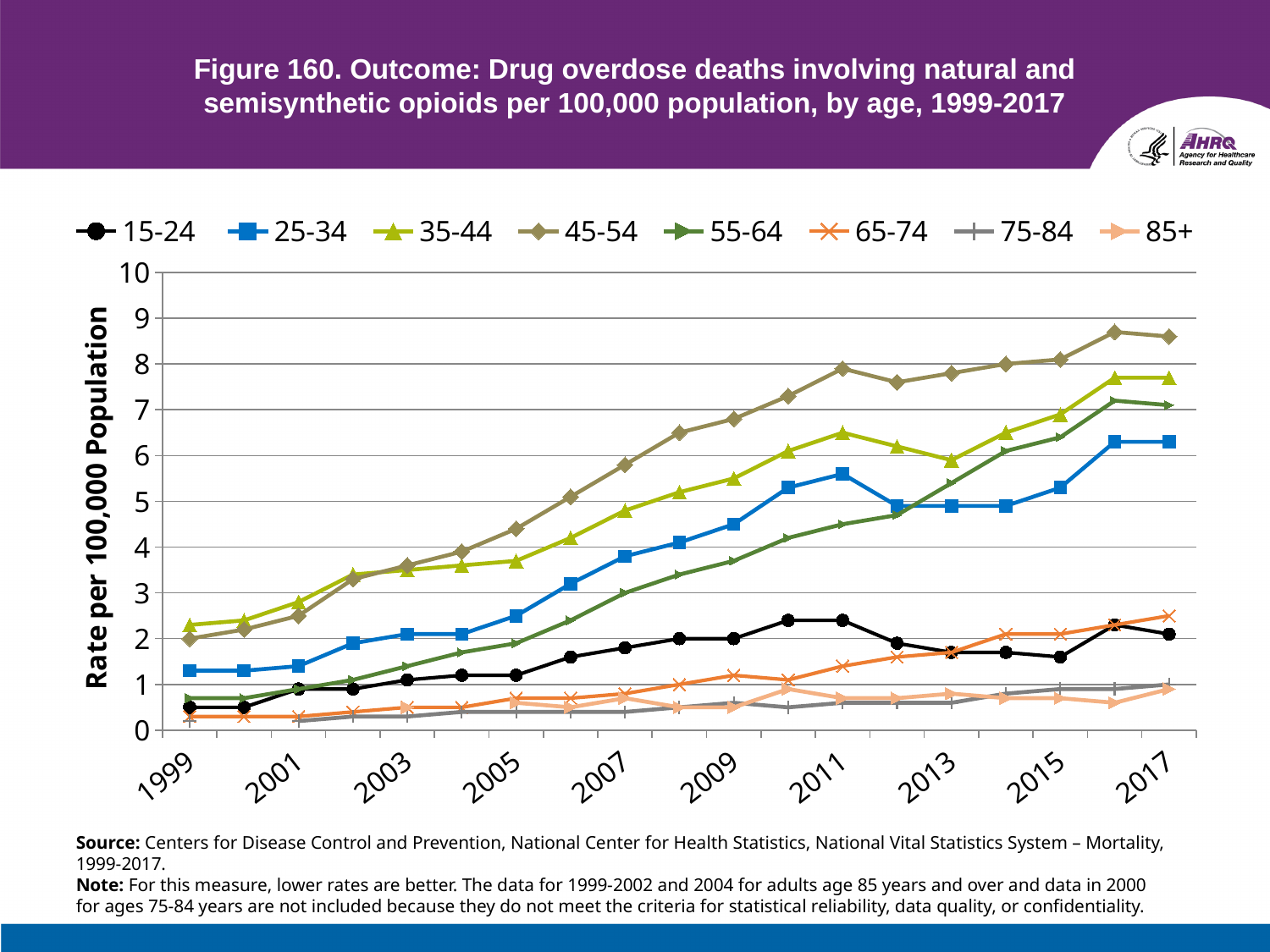
What is the title of the y axis? Rate per 100,000 Population Does the rate for the 45-54 age group generally rise or fall from 1999 to 2017? rise Which age group has the highest rate in 2017? 45-54 Is the value for the 15-24 age group in 2017 greater or less than 3? less Which age group is plotted with the black line and circle markers? 15-24 How many years of data are plotted along the x axis, from 1999 to 2017? 19 How many age-group series does the legend list? 8 Is the value for the 65-74 age group in 2017 greater or less than 2? greater What kind of chart is shown on the slide? line chart Is the value for the 25-34 age group in 2017 greater or less than 6? greater In 2017, which has the larger rate: the 25-34 age group or the 55-64 age group? 55-64